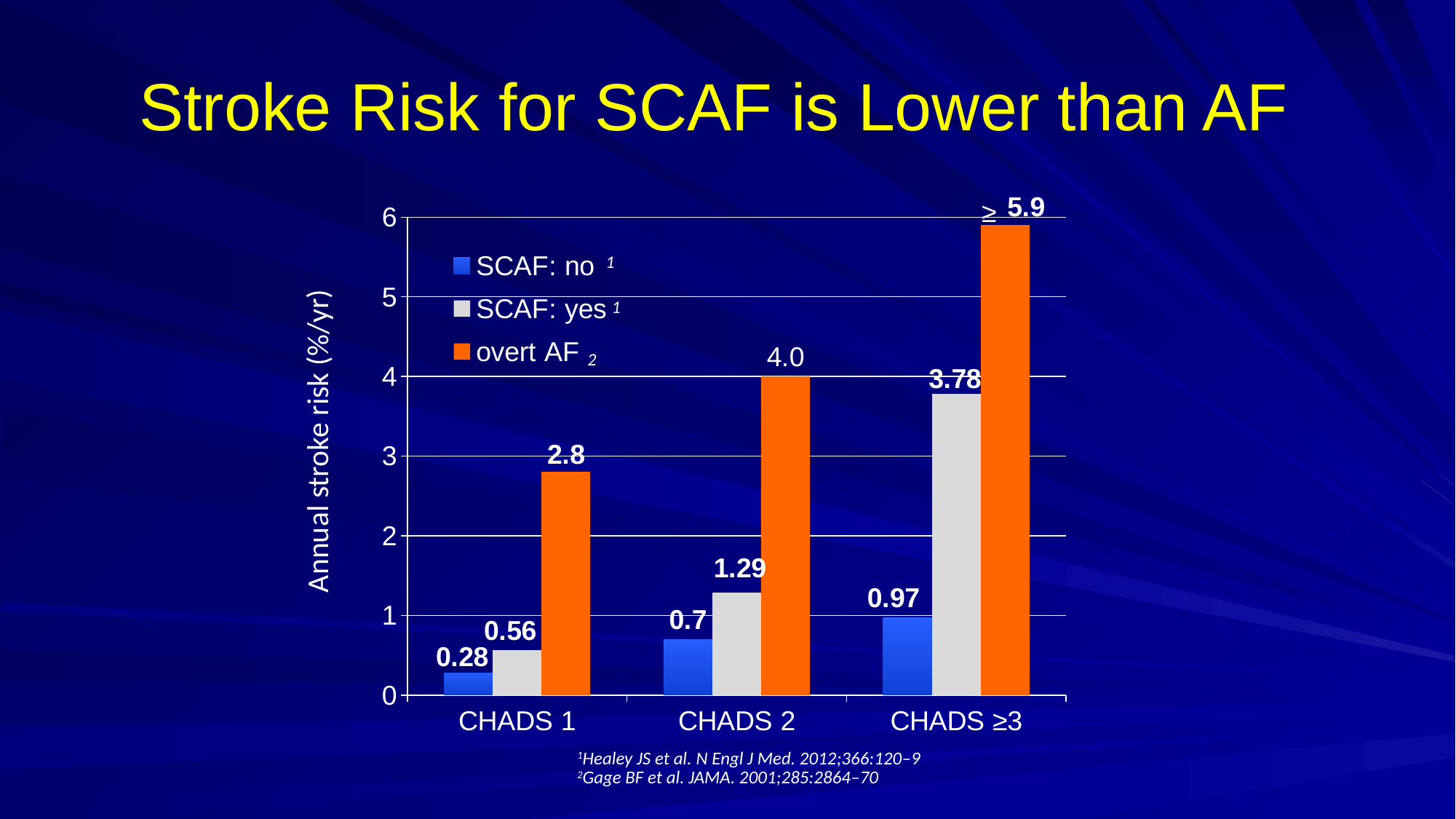
What is the annual stroke risk for overt AF at CHADS 2? 4.0 Which is larger at CHADS ≥3: the SCAF: yes value or the SCAF: no value? SCAF: yes What kind of chart is shown on the slide? Bar chart How many series does the legend list? 3 Which series has the lowest annual stroke risk at CHADS 1? SCAF: no What is the annual stroke risk for SCAF: yes at CHADS ≥3? 3.78 What is the annual stroke risk for SCAF: yes at CHADS 2? 1.29 Does the annual stroke risk for overt AF rise or fall from CHADS 1 to CHADS ≥3? Rise What is the annual stroke risk for SCAF: no at CHADS 1? 0.28 How many CHADS categories are shown on the x axis? 3 Which CHADS category has the highest annual stroke risk for SCAF: no? CHADS ≥3 What is the difference between the overt AF and SCAF: yes values at CHADS 2? 2.71